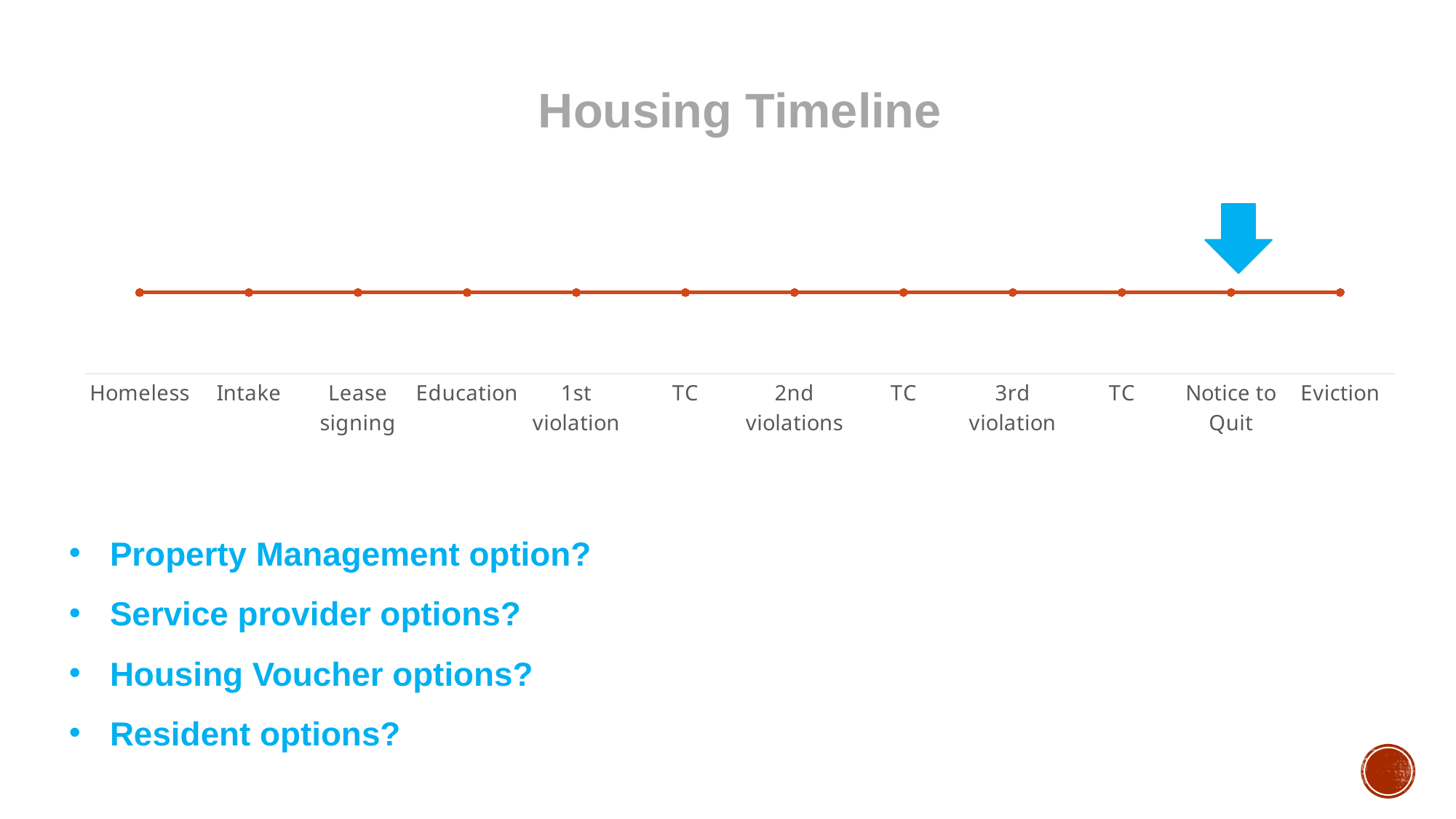
What is the title of the chart on the slide? Housing Timeline What is the first category on the x axis of the Housing Timeline chart? Homeless What kind of chart is used to show the Housing Timeline? line chart Do the plotted values rise, fall, or stay flat along the x axis of the Housing Timeline chart? stay flat Which category comes immediately before "Eviction" on the Housing Timeline chart? Notice to Quit Which category comes immediately after "Intake" on the Housing Timeline chart? Lease signing How many x-axis categories on the Housing Timeline chart are labelled "TC"? 3 Which category on the Housing Timeline chart does the blue arrow point to? Notice to Quit